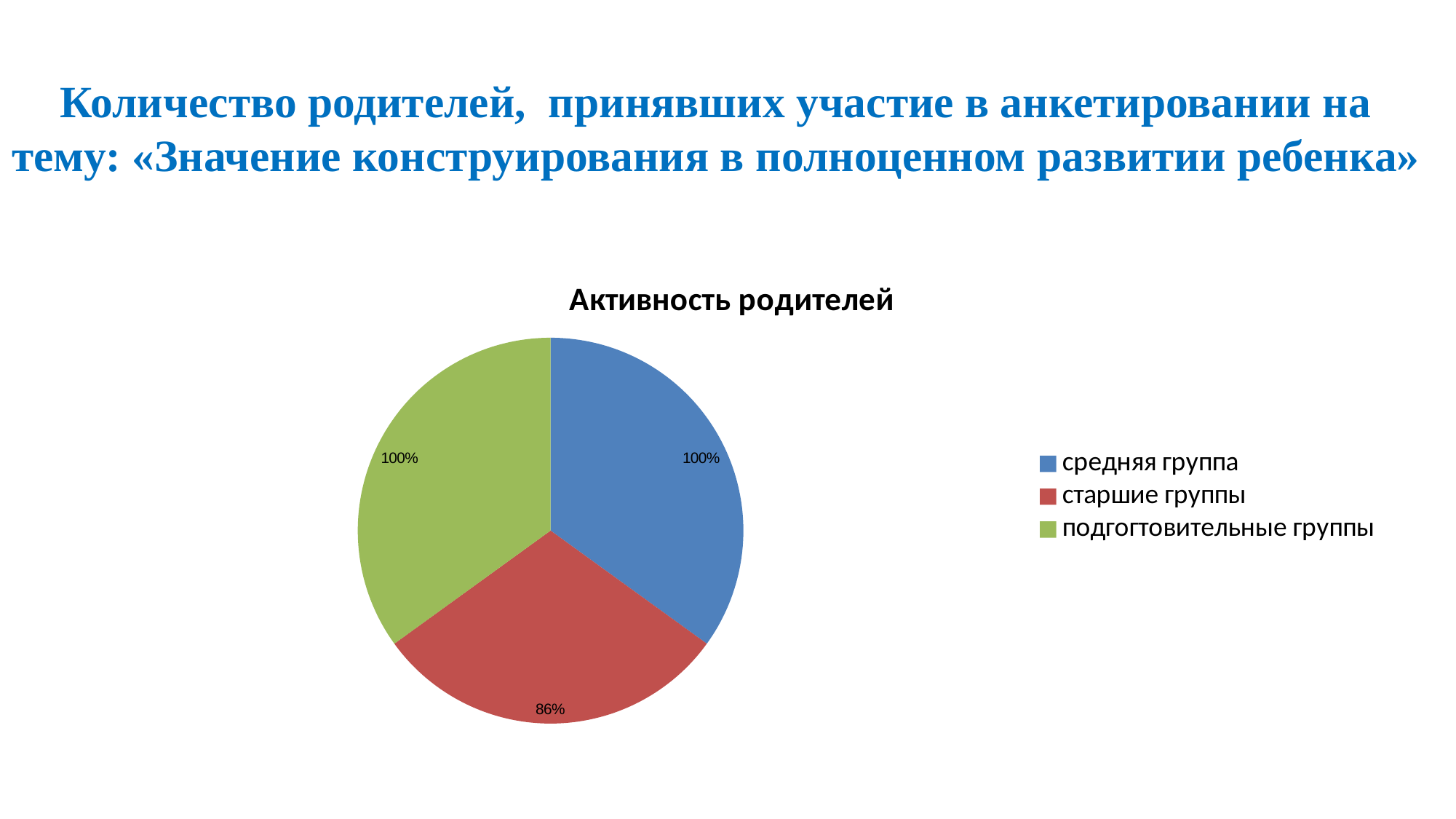
What is the difference between the value for средняя группа and the value for старшие группы? 14% What value is shown for старшие группы in the pie chart? 86% What value is shown for подготовительные группы in the pie chart? 100% Which is larger: the value for старшие группы or the value for подготовительные группы? подготовительные группы What value is shown for средняя группа in the pie chart? 100% What is the title of the chart? Активность родителей How many entries does the legend list? 3 What kind of chart is shown on the slide? pie chart Which category has the lowest value in the pie chart? старшие группы How many categories are shown in the pie chart? 3 Which category is shown in red in the pie chart? старшие группы Which is larger: the value for средняя группа or the value for старшие группы? средняя группа